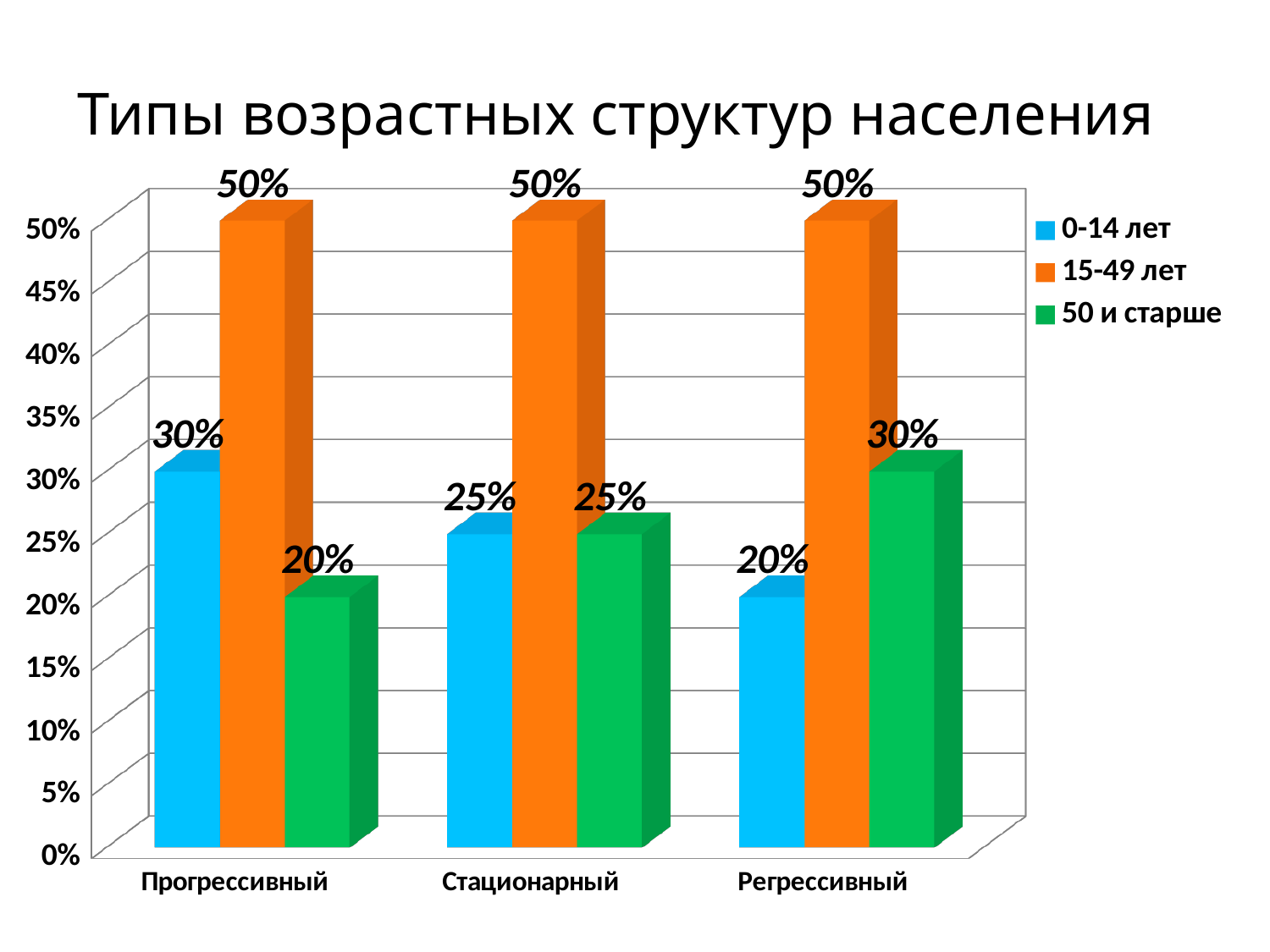
What is the difference between the 0-14 лет and 50 и старше values in the Прогрессивный category? 10% What is the title of the chart? Типы возрастных структур населения How many categories are shown on the x axis? 3 Which is larger in the Регрессивный category: 0-14 лет or 50 и старше? 50 и старше What is the value for 50 и старше in the Регрессивный category? 30% What is the value for 15-49 лет in the Стационарный category? 50% Which category has the highest value for 50 и старше? Регрессивный What is the value for 0-14 лет in the Прогрессивный category? 30% What kind of chart is shown on the slide? Bar chart Which category has the lowest value for 0-14 лет? Регрессивный What is the value for 50 и старше in the Прогрессивный category? 20% How many series does the legend list? 3